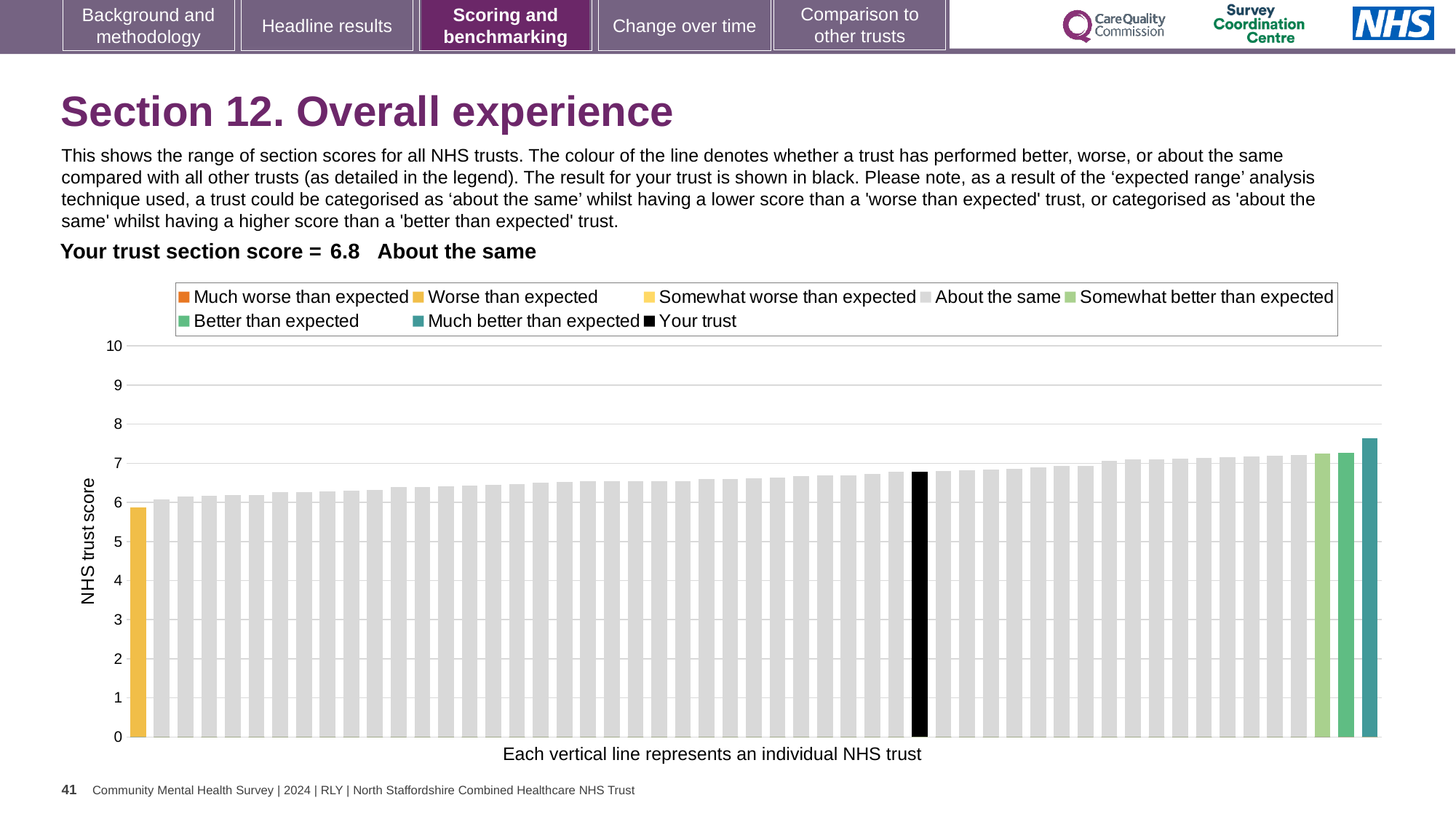
Do the trust scores rise or fall from left to right along the x axis? rise What is the title of the vertical axis? NHS trust score What type of chart is shown on the slide? bar chart Is the value of the tallest bar (the teal bar on the far right) greater or less than 7? greater Which legend category does the lowest-scoring trust (the leftmost bar) belong to? Worse than expected Which legend category does the highest-scoring trust (the rightmost bar) belong to? Much better than expected Is the value for your trust (the black bar) greater or less than 7? less Is the value for your trust (the black bar) greater or less than 6? greater How many entries does the chart legend list? 8 What is the section score for your trust shown on the slide? 6.8 Which category is your trust placed in for this section? About the same